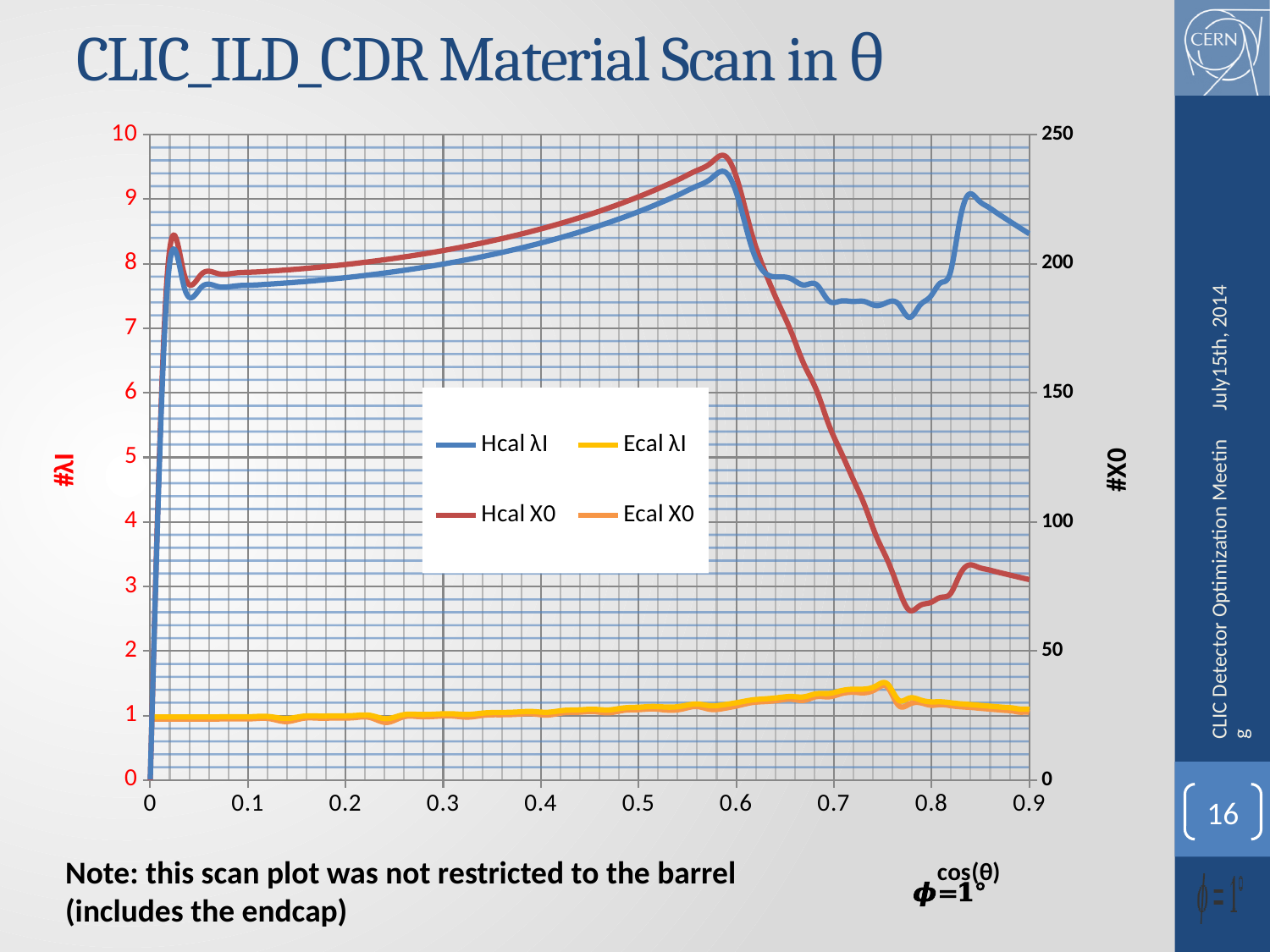
Which series are listed in the chart legend? Hcal λI, Ecal λI, Hcal X0, Ecal X0 Is the Hcal X0 value larger at cos(θ) = 0.3 or at cos(θ) = 0.8? 0.3 Is the value of Hcal λI at cos(θ) = 0.3 greater or less than 7 on the left axis? greater How many series does the chart legend list? 4 Is the value of Ecal λI at cos(θ) = 0.5 greater or less than 2 on the left axis? less Is the value of Hcal X0 at cos(θ) = 0.5 greater or less than 200 on the right axis? greater At cos(θ) = 0.5, which series has the larger value on the left axis, Hcal λI or Ecal λI? Hcal λI What is the label of the right-hand vertical axis? #X0 What kind of chart is shown on the slide? line chart Does the Hcal X0 line rise or fall between cos(θ) = 0.6 and cos(θ) = 0.78? fall